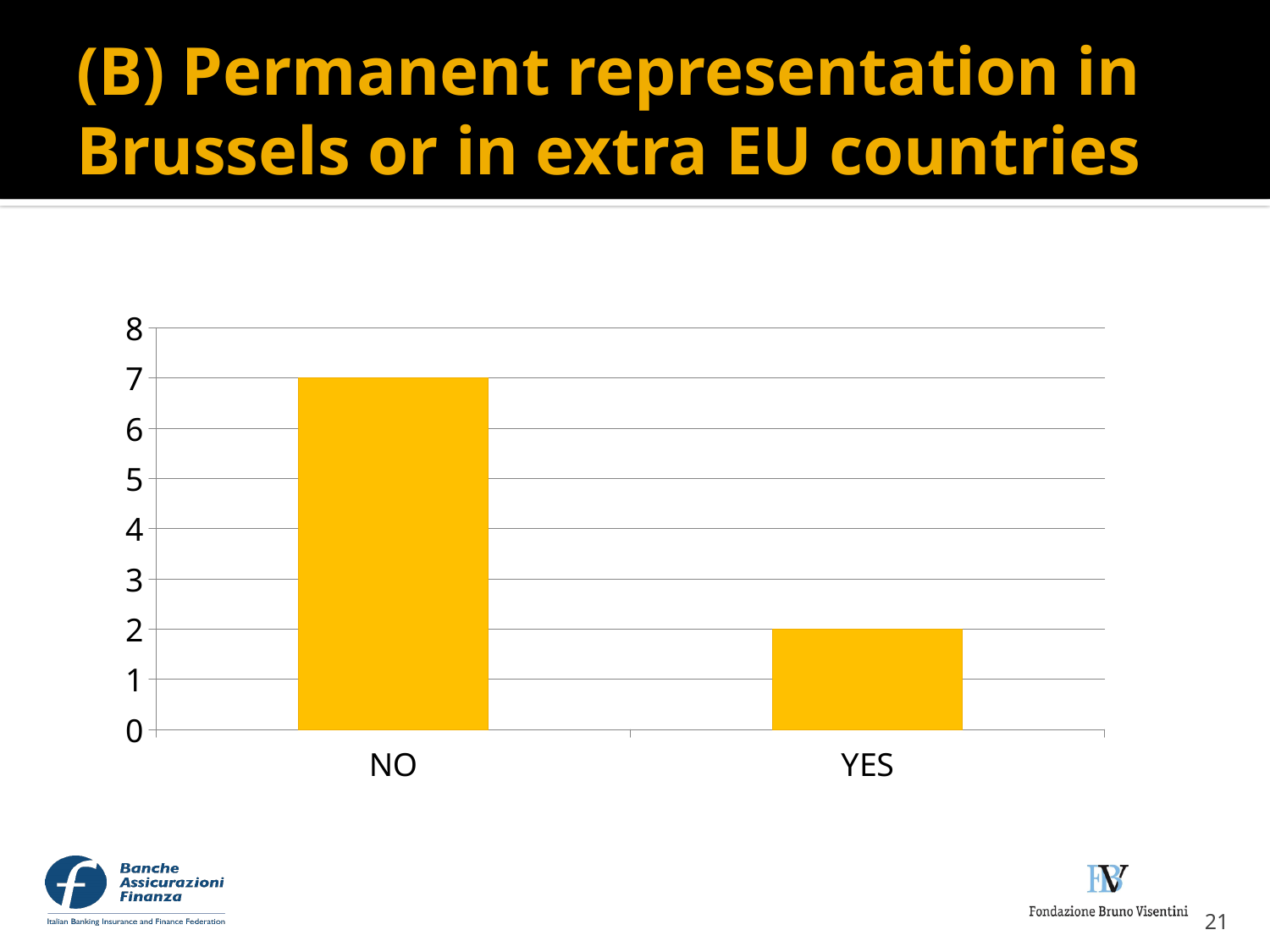
What kind of chart is shown on the slide? bar chart What is the value for YES? 2 How many categories are shown on the x axis? 2 What is the maximum value shown on the y axis? 8 What colour are the bars in the chart? yellow What is the value for NO? 7 Which category has the lowest value? YES Which is larger, the value for NO or the value for YES? NO Is the value for NO greater or less than 5? greater Is the value for YES greater or less than 4? less Which category has the highest value? NO What is the difference between the values for NO and YES? 5